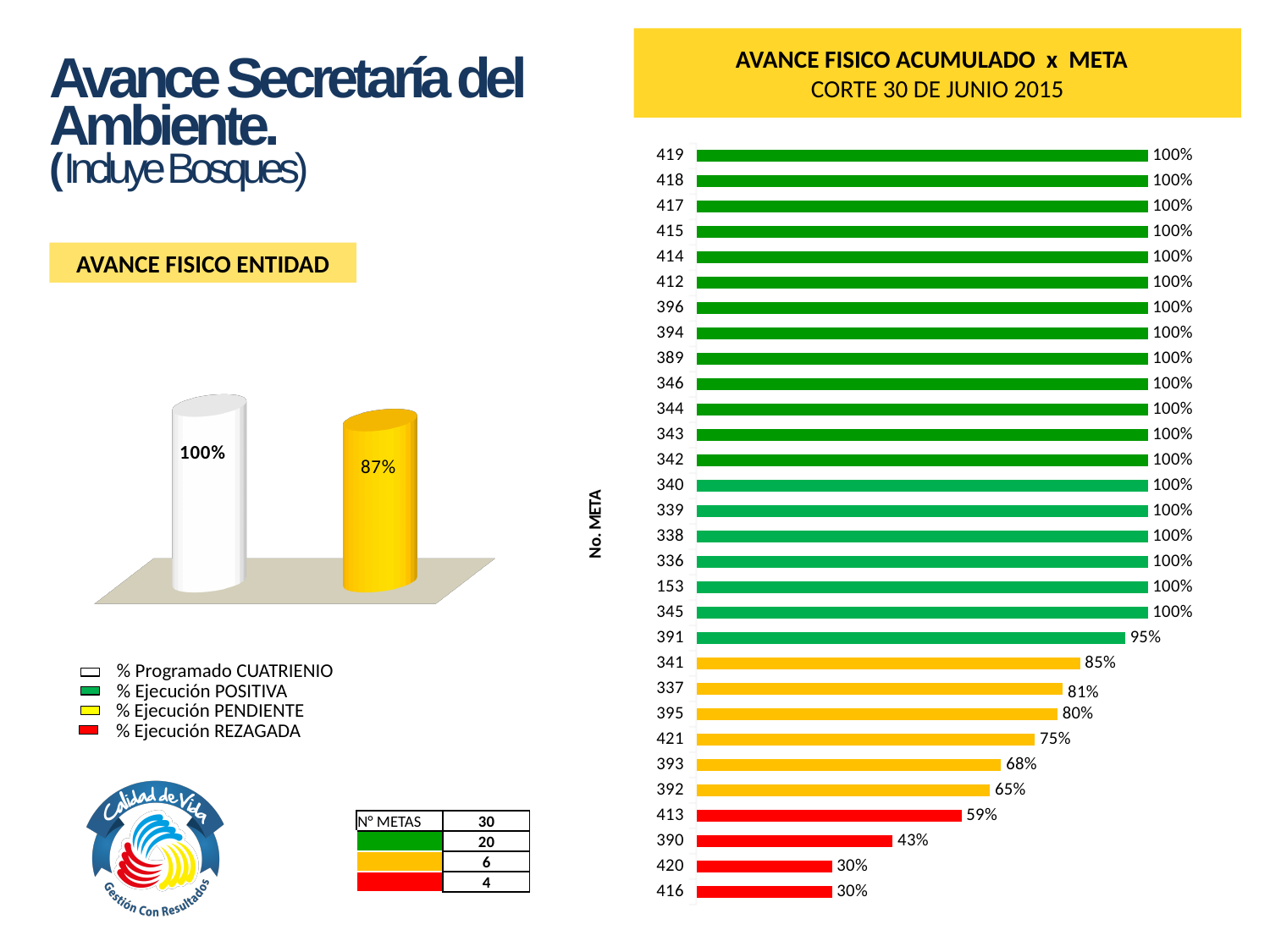
In the chart titled 'AVANCE FISICO ACUMULADO x META', what is the difference between the values for meta 341 and meta 337? 4 percentage points What kind of chart is the one titled 'AVANCE FISICO ACUMULADO x META'? Bar chart In the chart titled 'AVANCE FISICO ACUMULADO x META', which has a larger value, meta 421 or meta 393? 421 In the chart titled 'AVANCE FISICO ENTIDAD', what is the difference between the white bar and the yellow bar? 13 percentage points In the chart titled 'AVANCE FISICO ACUMULADO x META', what is the value for meta 390? 43% How many entries does the legend below the chart titled 'AVANCE FISICO ENTIDAD' list? 4 In the chart titled 'AVANCE FISICO ACUMULADO x META', do the values rise or fall going from the top bar to the bottom bar? Fall In the chart titled 'AVANCE FISICO ENTIDAD', what is the value of the yellow bar? 87% How many metas are plotted in the chart titled 'AVANCE FISICO ACUMULADO x META'? 30 In the chart titled 'AVANCE FISICO ACUMULADO x META', what is the value for meta 413? 59% In the chart titled 'AVANCE FISICO ACUMULADO x META', what is the lowest value shown? 30% In the chart titled 'AVANCE FISICO ACUMULADO x META', what is the value for meta 391? 95%